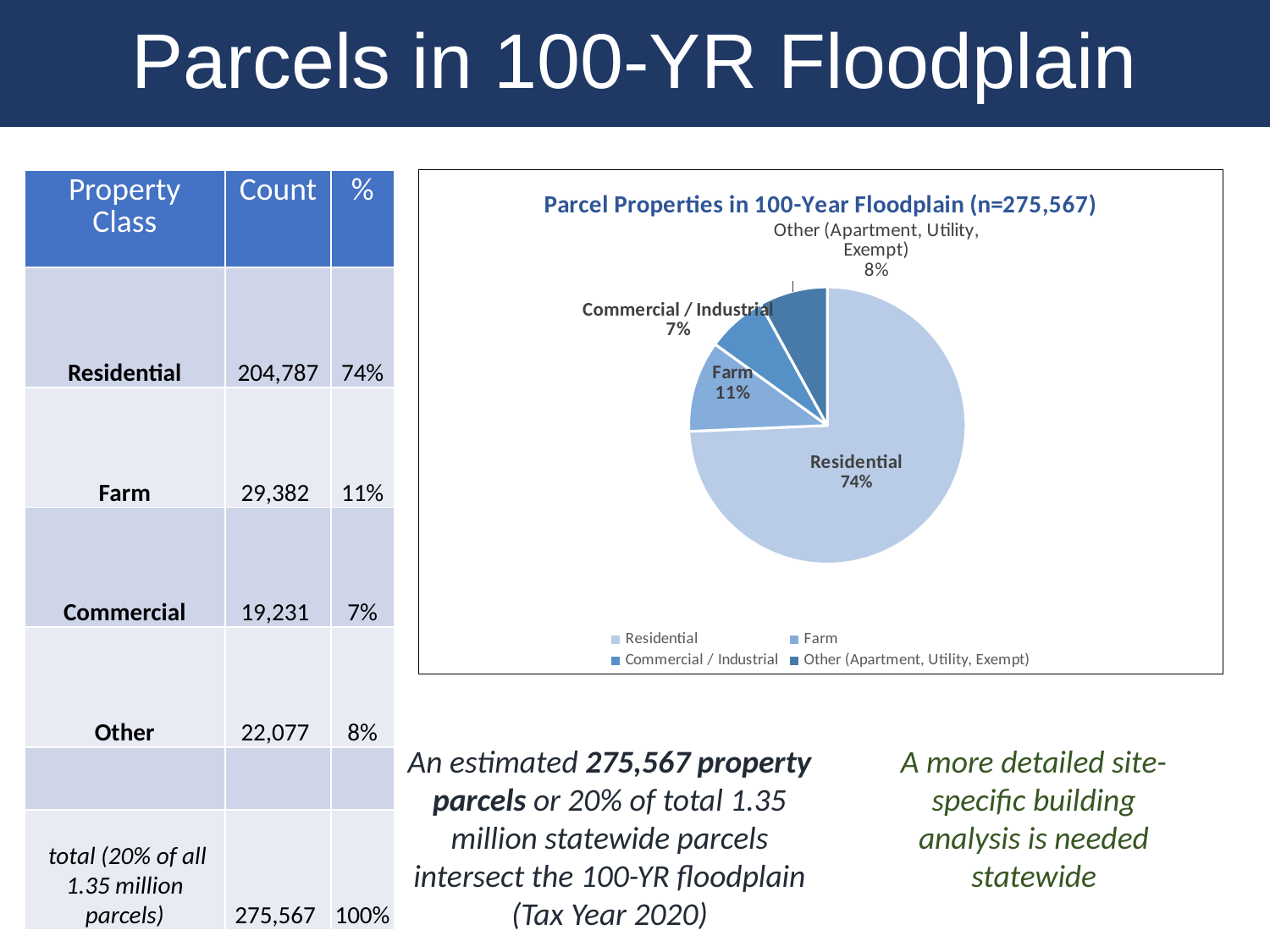
What is the title of the pie chart? Parcel Properties in 100-Year Floodplain (n=275,567) Which slice of the pie chart is the largest? Residential How many slices does the pie chart have? 4 What share of the pie does Farm represent? 11% What is the difference in percentage points between the Residential and Farm slices? 63 Which slice is larger, Farm or Other (Apartment, Utility, Exempt)? Farm Which slice of the pie chart is the smallest? Commercial / Industrial What share of the pie does Commercial / Industrial represent? 7% What share of the pie does Other (Apartment, Utility, Exempt) represent? 8% What kind of chart is shown on the slide? pie chart How many entries does the legend of the pie chart list? 4